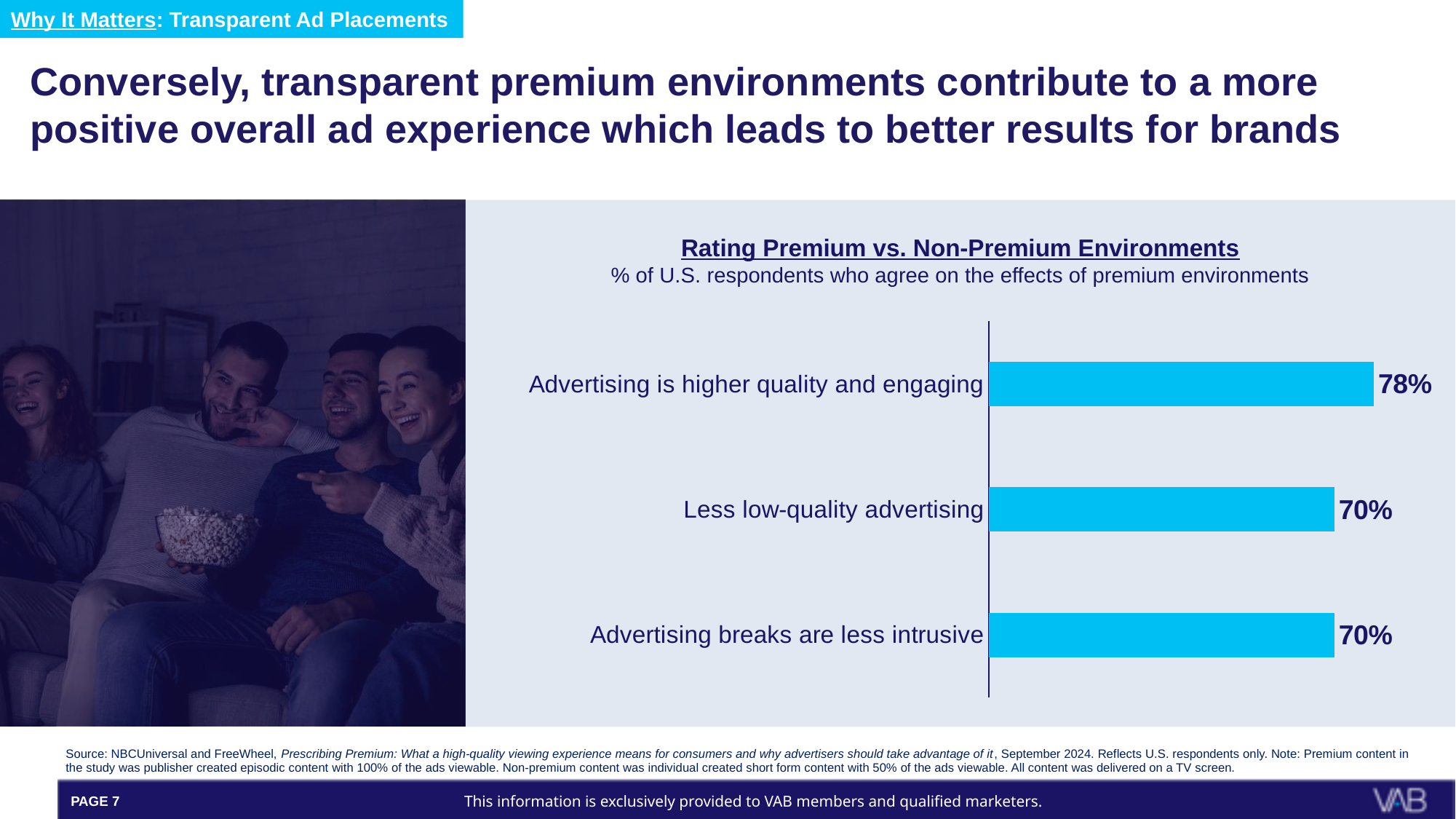
What is the value for 'Less low-quality advertising'? 70% Which category has the highest value in the chart? Advertising is higher quality and engaging How many categories are shown in the chart? 3 What is the difference between the value for 'Advertising is higher quality and engaging' and the value for 'Less low-quality advertising'? 8% Do 'Less low-quality advertising' and 'Advertising breaks are less intrusive' have the same value? Yes What kind of chart is shown on the slide? Bar chart Which is larger: the value for 'Advertising is higher quality and engaging' or the value for 'Advertising breaks are less intrusive'? Advertising is higher quality and engaging What is the value for 'Advertising breaks are less intrusive'? 70% What is the title of the chart? Rating Premium vs. Non-Premium Environments What colour are the bars in the chart? Light blue What percentage of respondents agree that advertising is higher quality and engaging in premium environments? 78%